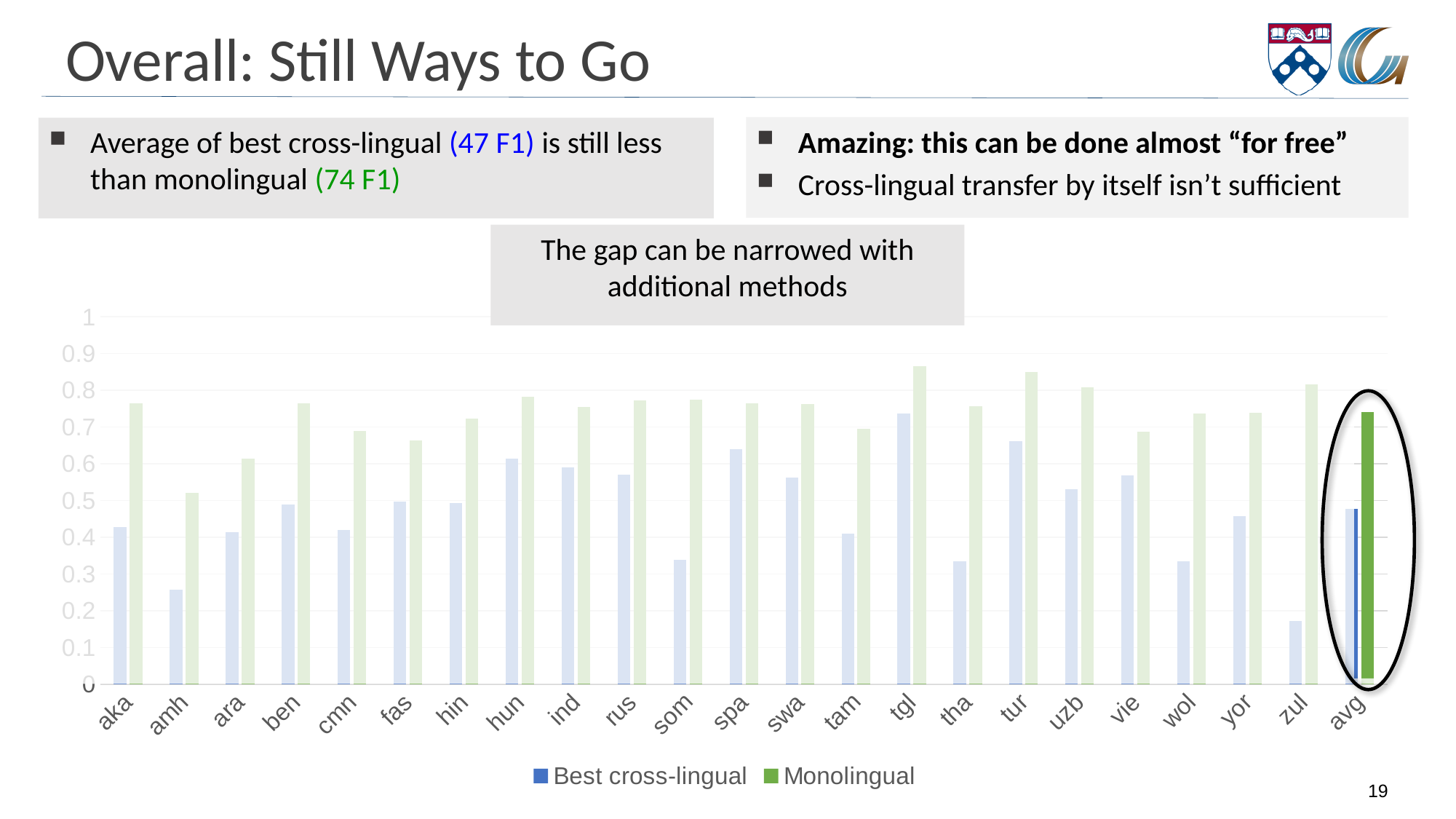
Which category has the lowest Best cross-lingual value? zul Is the Best cross-lingual value for zul greater or less than 0.2? less Is the Monolingual value for tgl greater or less than 0.8? greater What kind of chart is shown on the slide? bar chart How many series does the chart legend list? 2 For the category avg, which is larger: the Best cross-lingual value or the Monolingual value? Monolingual Which is larger: the Best cross-lingual value for tgl or the Best cross-lingual value for amh? tgl How many categories are shown along the x axis of the chart? 23 What are the two series named in the chart legend? Best cross-lingual and Monolingual Is the Best cross-lingual value for amh greater or less than 0.3? less Which category has the lowest Monolingual value? amh Which category has the highest Best cross-lingual value? tgl